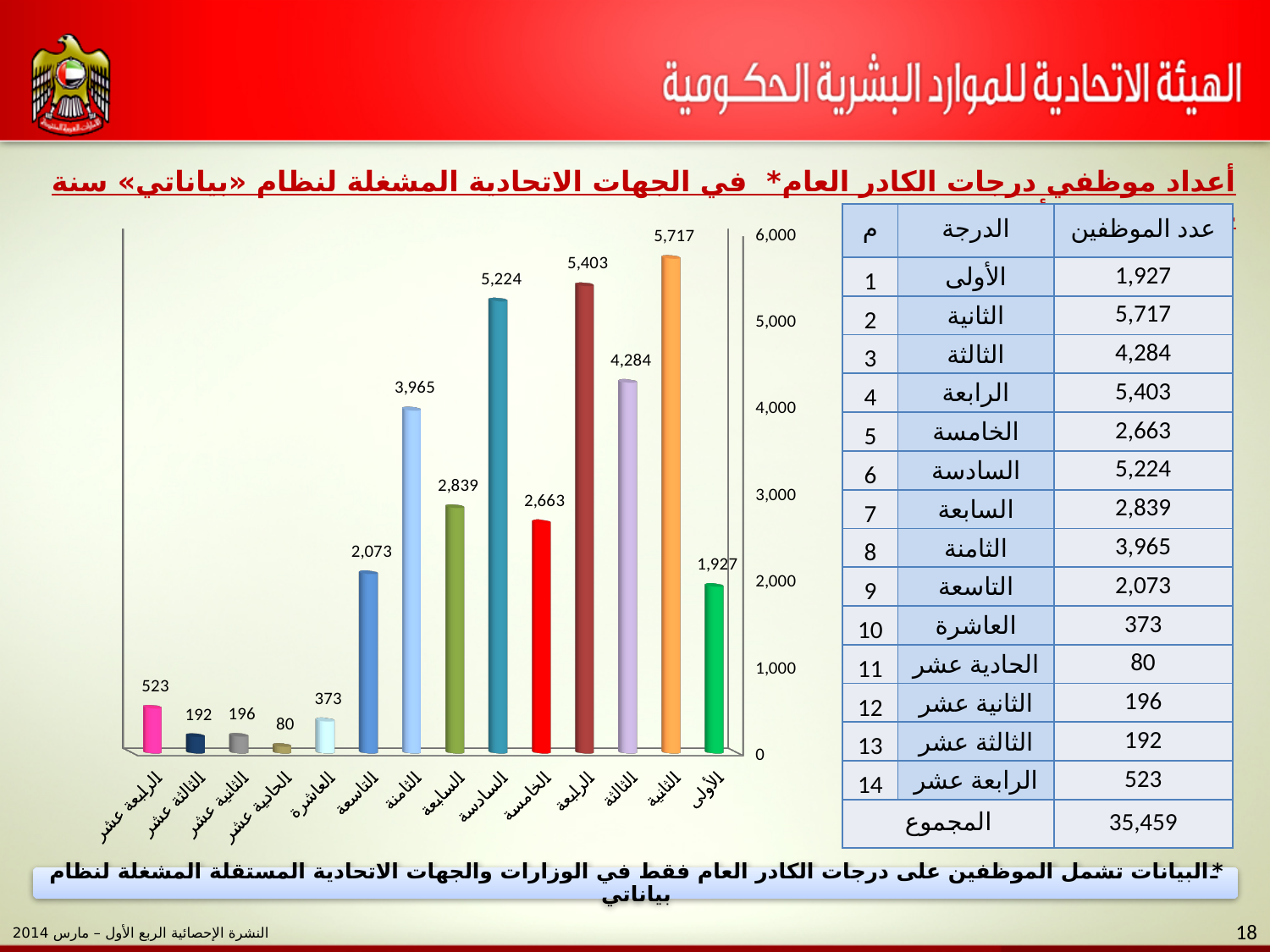
What is the difference between the values for الرابعة and الثالثة? 1,119 Which grade has the highest number of employees in the chart? الثانية Which is larger, the value for السادسة or the value for الرابعة? الرابعة What is the difference between the values for الرابعة عشر and العاشرة? 150 What type of chart is shown on the slide? bar chart What is the value shown for the grade الثانية? 5,717 Which grade has the lowest number of employees in the chart? الحادية عشر What is the value shown for the grade الثامنة? 3,965 Is the value for الخامسة greater or less than 3,000? less What is the value shown for the grade الحادية عشر? 80 What is the highest value labelled on the vertical axis of the chart? 6,000 How many grade categories are plotted in the chart? 14